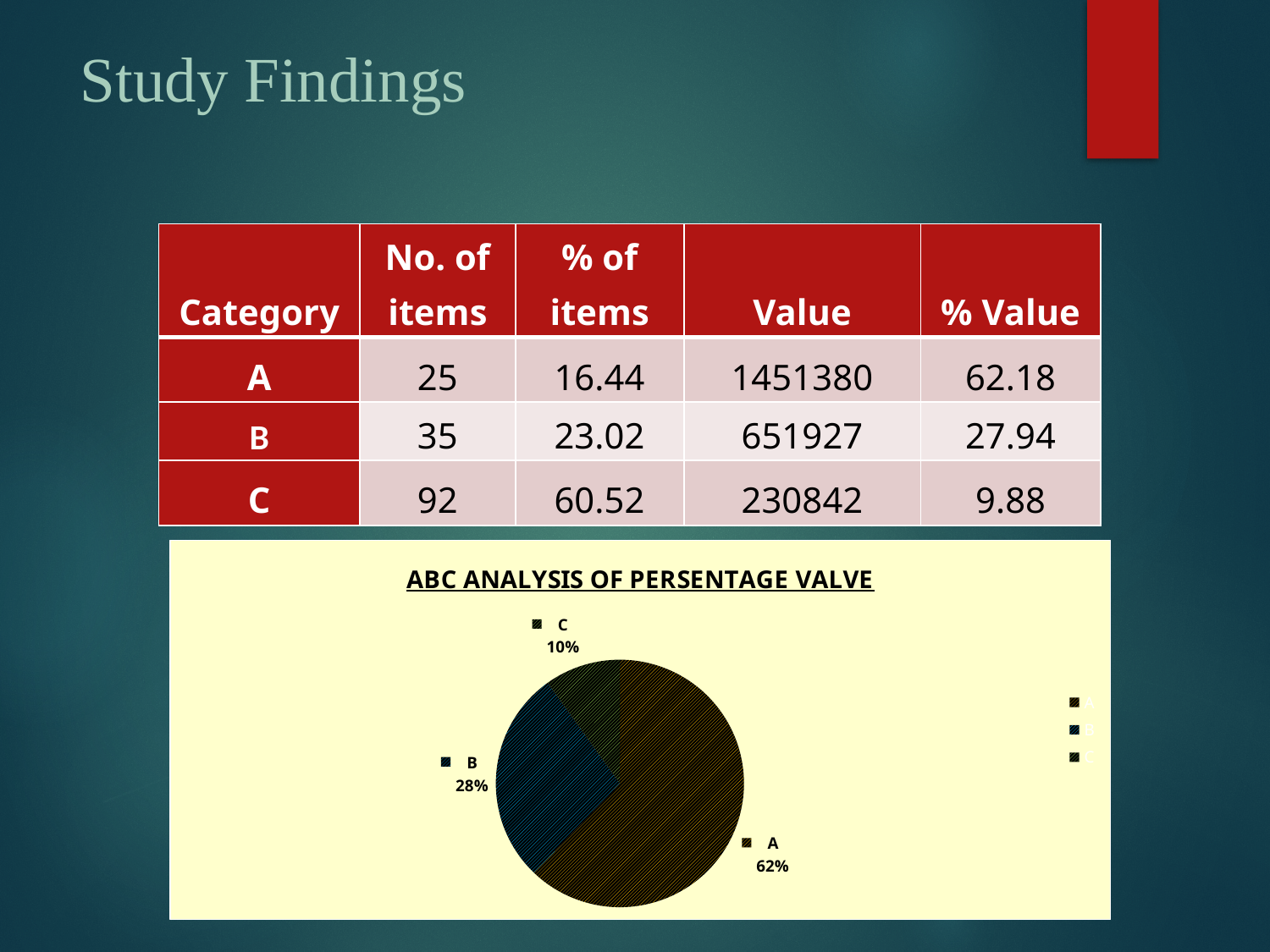
Which is larger, slice B or slice C? B What is the title of the chart? ABC ANALYSIS OF PERSENTAGE VALVE How many entries does the chart's legend list? 3 Which slice of the pie is the smallest? C Which slice of the pie is the largest? A What share of the pie does slice B represent? 28% What kind of chart is shown on the slide? pie chart What share of the pie does slice C represent? 10% What share of the pie does slice A represent? 62% What is the difference in percentage points between slice B and slice C? 18 What is the difference in percentage points between slice A and slice B? 34 How many slices does the pie chart have? 3